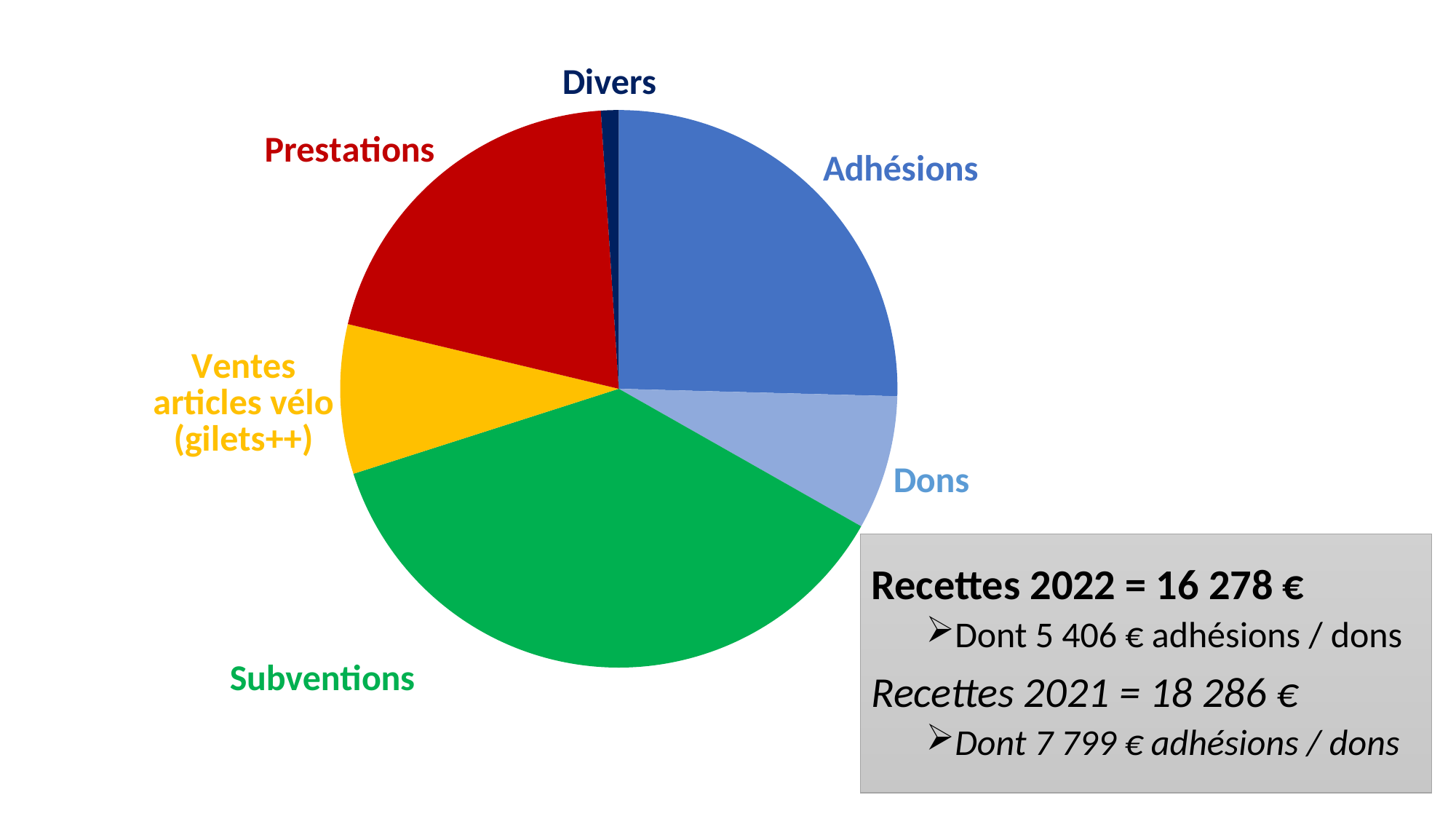
By how much did the Recettes fall from 2021 (18 286 €) to 2022 (16 278 €)? 2 008 € Which category has the smallest slice of the pie chart? Divers Which slice is larger, Adhésions or Dons? Adhésions What colour is the Subventions slice? Green Which category has the largest slice of the pie chart? Subventions According to the text box, how much of the 2021 recettes came from adhésions / dons? 7 799 € How many slices does the pie chart have? 6 Which slice is larger, Dons or Divers? Dons What kind of chart is shown on the slide? Pie chart Which slice is larger, Subventions or Adhésions? Subventions According to the text box, what were the total Recettes 2022? 16 278 €